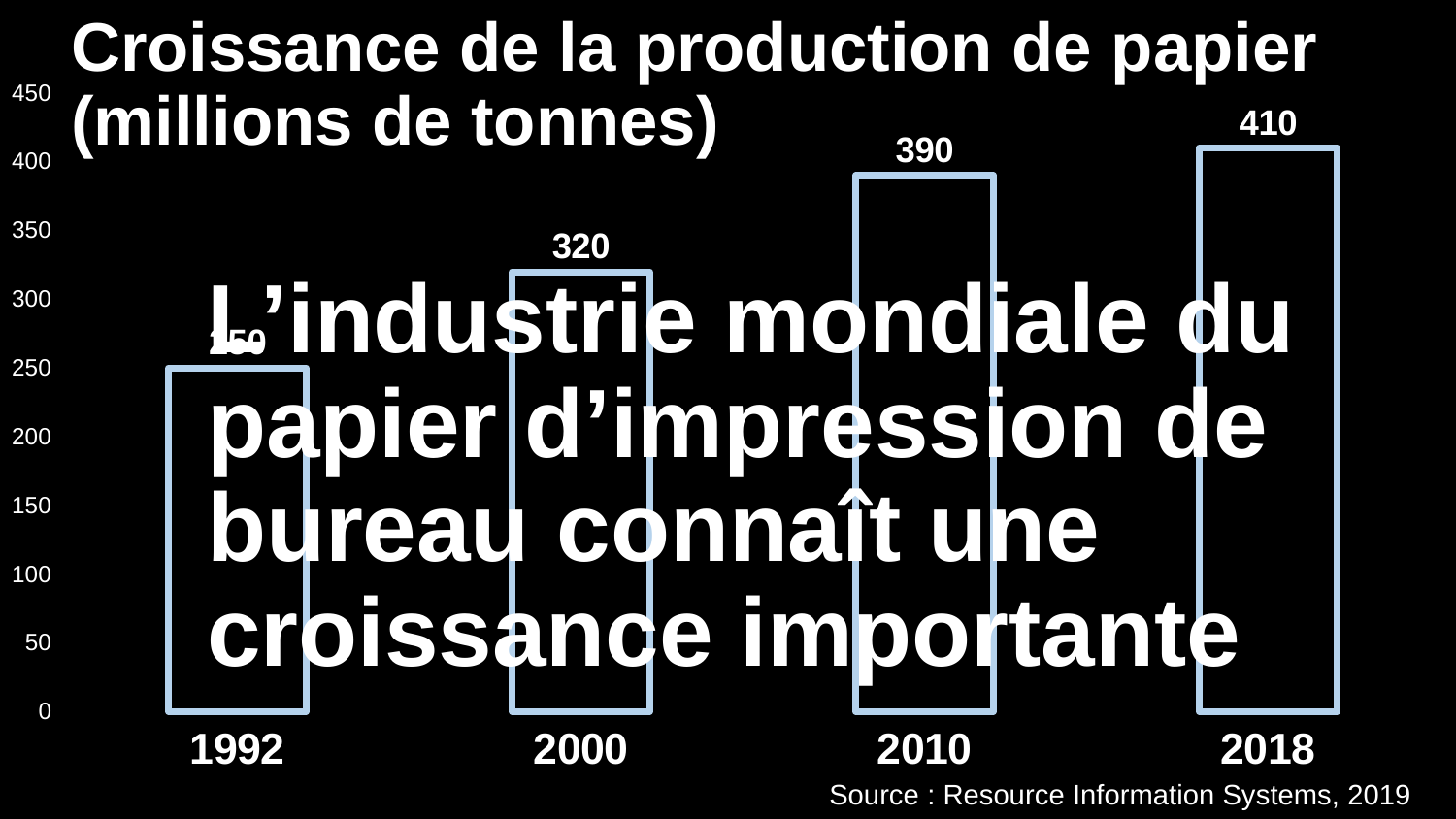
Which year has the highest value? 2018 What is the value for 2018? 410 Which year has the lowest value? 1992 Do the values rise or fall from 1992 to 2018? rise How many years are shown on the x axis? 4 What is the value for 2010? 390 What is the value for 2000? 320 Which is larger, the value for 2000 or the value for 2010? 2010 What kind of chart is shown on the slide? bar chart What is the difference between the values for 2018 and 2010? 20 What is the difference between the values for 2010 and 2000? 70 Is the value for 1992 greater or less than 200? greater